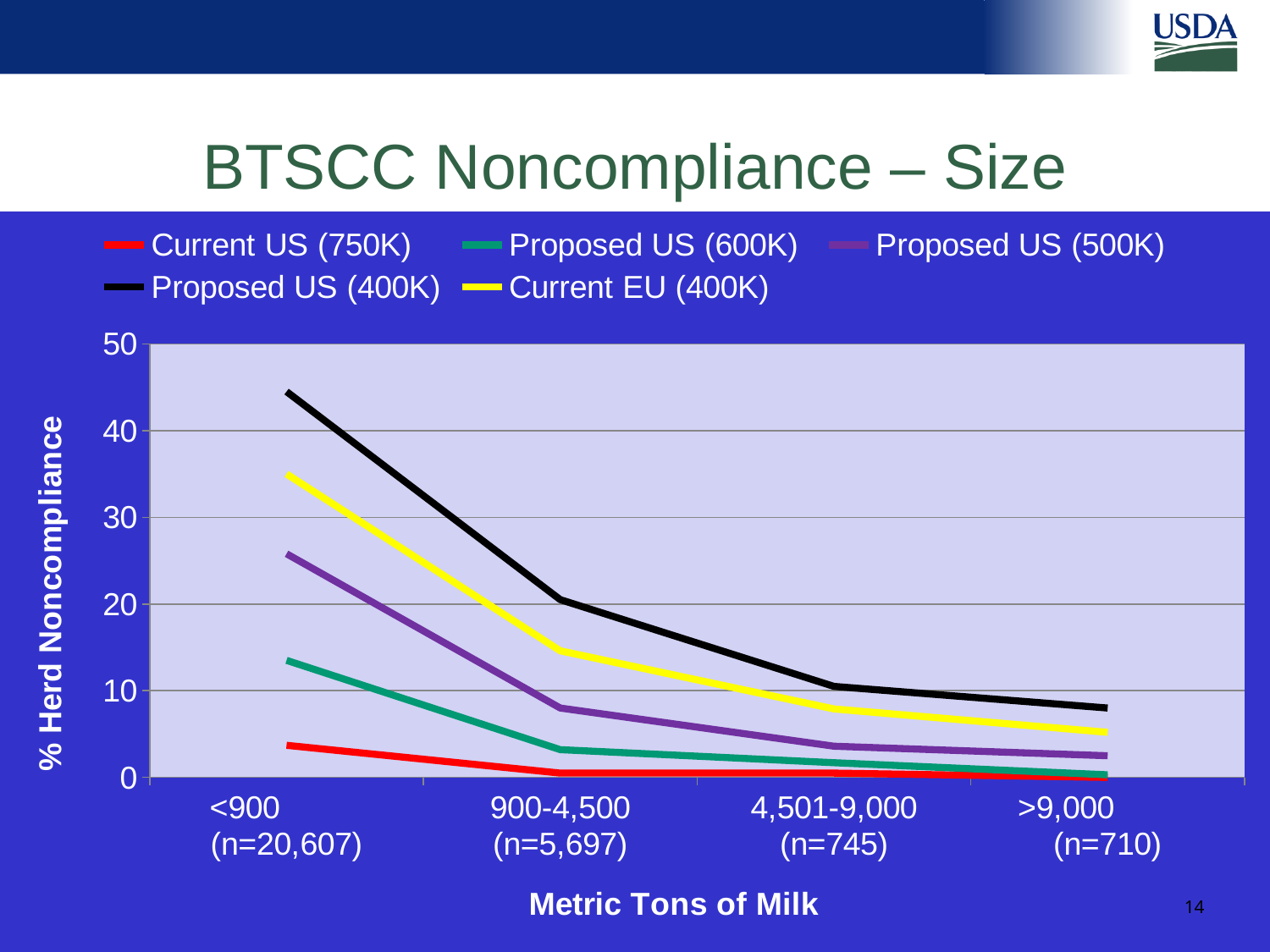
Is the value for Proposed US (400K) at <900 greater or less than 40? greater Which series has the highest % herd noncompliance for the <900 category? Proposed US (400K) What is the title of the x axis? Metric Tons of Milk Is the value for Current EU (400K) at <900 greater or less than 30? greater How many herd size categories are shown on the x axis? 4 How many series does the legend list? 5 What kind of chart is shown on the slide? line chart Is the value for Proposed US (500K) at 900-4,500 greater or less than 10? less At 4,501-9,000 metric tons, which is larger: Current EU (400K) or Proposed US (500K)? Current EU (400K) Do the values for Proposed US (400K) rise or fall as herd size increases along the x axis? fall Which series has the lowest % herd noncompliance for the <900 category? Current US (750K)